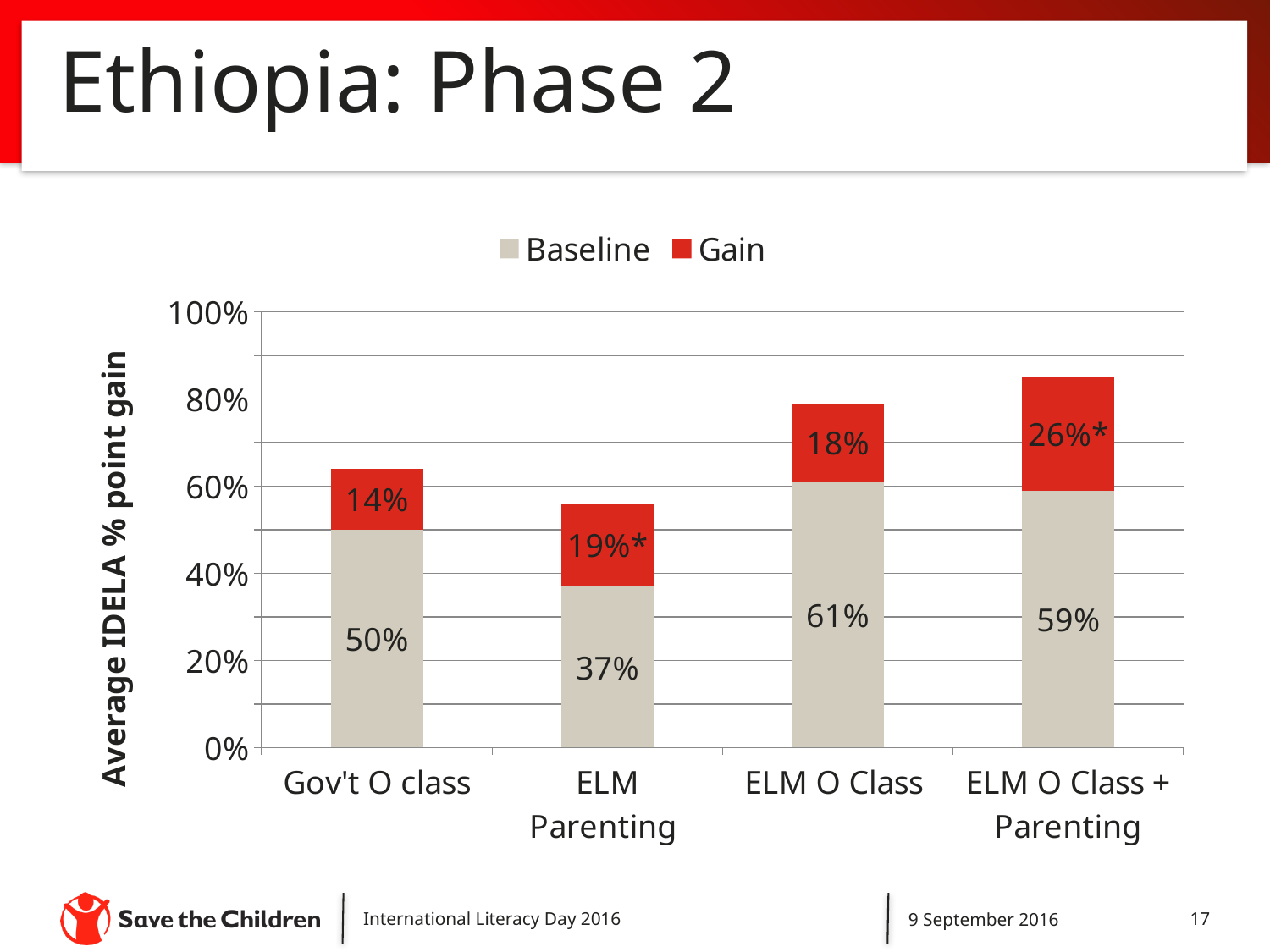
What is the Gain value for ELM O Class + Parenting, as labelled on the chart? 26%* What is the Gain value for ELM O Class? 18% Which category has the highest Baseline value? ELM O Class What is the Baseline value for Gov't O class? 50% Which category has the lowest Gain value? Gov't O class Which is larger, the Gain for ELM Parenting or the Gain for ELM O Class? ELM Parenting Is the total of the stacked bar for ELM O Class + Parenting greater or less than 80%? greater How many categories are shown on the x axis? 4 How many series does the legend list? 2 What is the Baseline value for ELM Parenting? 37% What is the total height of the stacked bar for Gov't O class? 64% What is the difference between the Baseline values for ELM O Class and ELM Parenting? 24%